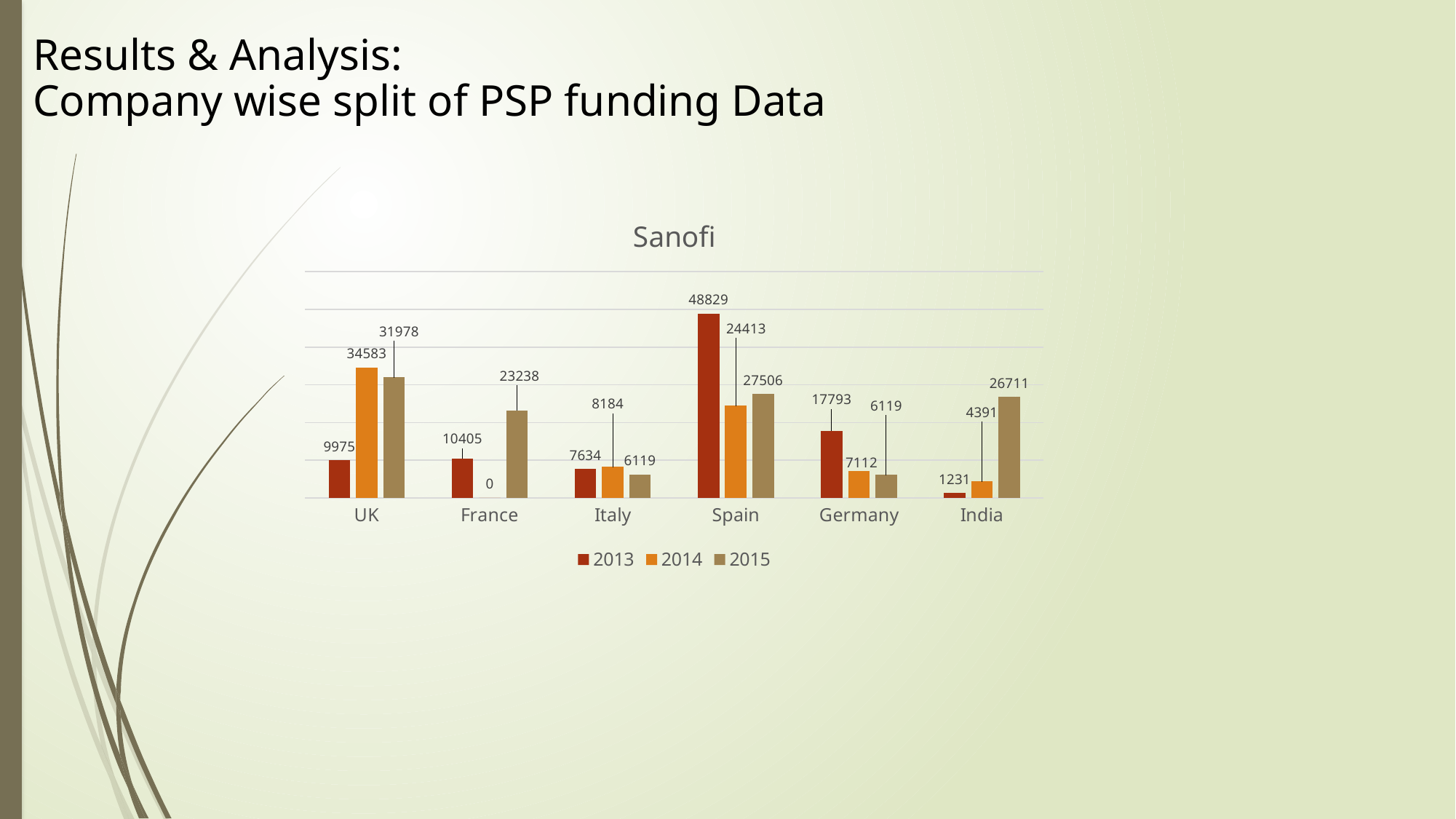
Which country has the highest 2013 value? Spain What is the 2014 value for the UK? 34583 Which country has the lowest 2013 value? India What is the difference between the 2013 and 2014 values for Spain? 24416 What is the 2013 value for Spain? 48829 What is the 2015 value for India? 26711 Which is larger, the 2015 value for the UK or the 2015 value for Spain? UK How many series does the legend list? 3 What is the title of the chart? Sanofi What kind of chart is shown? Bar chart How many countries are shown on the x axis? 6 What is the 2014 value for France? 0